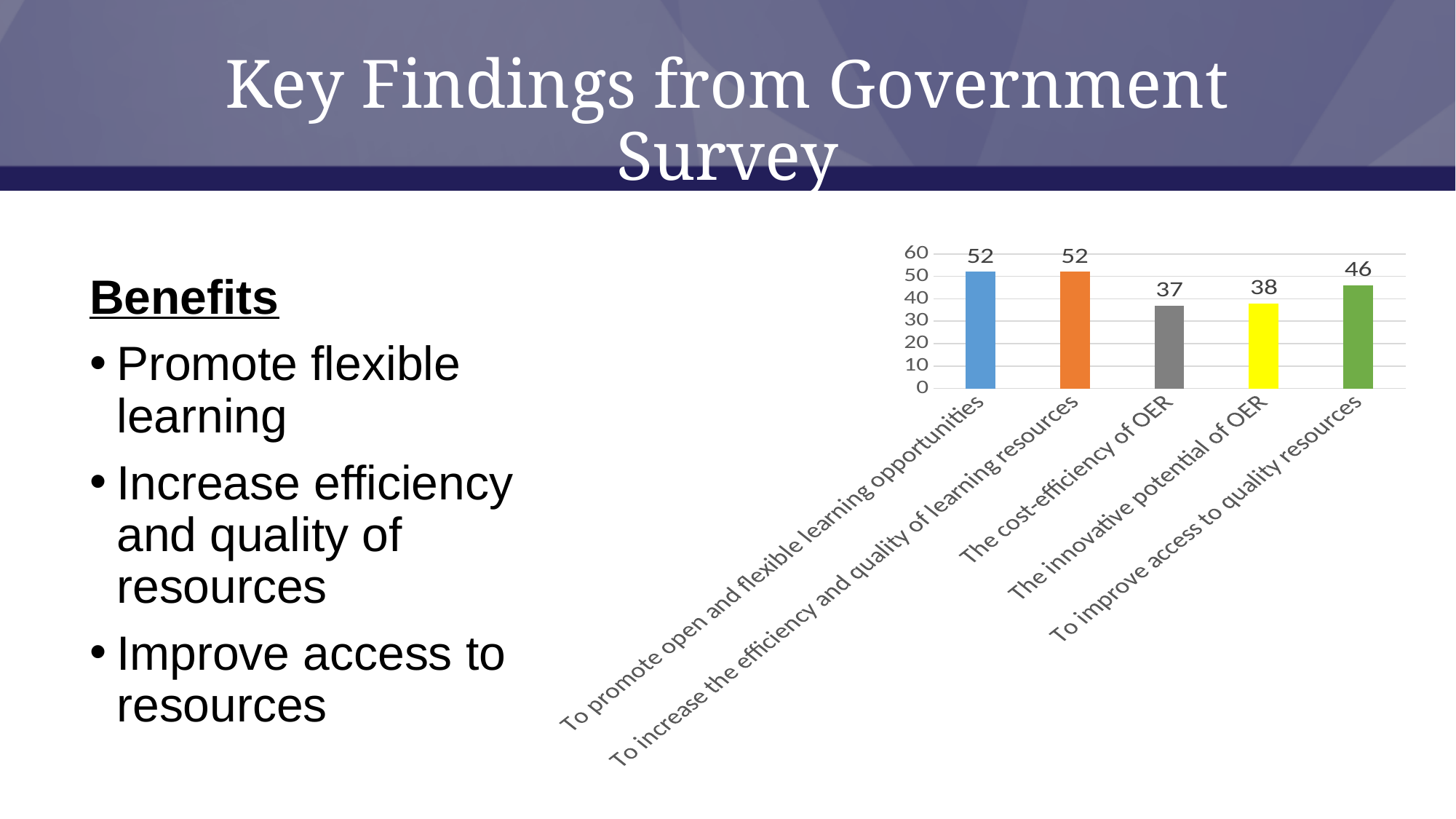
What kind of chart is shown on the slide? bar chart What colour is the bar for 'The innovative potential of OER'? yellow What is the value for 'The cost-efficiency of OER'? 37 What is the value for 'The innovative potential of OER'? 38 Is the value for 'The cost-efficiency of OER' greater or less than 40? less What is the value for 'To promote open and flexible learning opportunities'? 52 How many categories are shown in the chart? 5 Which category has the lowest value? The cost-efficiency of OER What is the value for 'To improve access to quality resources'? 46 Which is larger: 'To improve access to quality resources' or 'The innovative potential of OER'? To improve access to quality resources What is the difference between 'To improve access to quality resources' and 'The innovative potential of OER'? 8 What is the difference between 'To increase the efficiency and quality of learning resources' and 'The cost-efficiency of OER'? 15